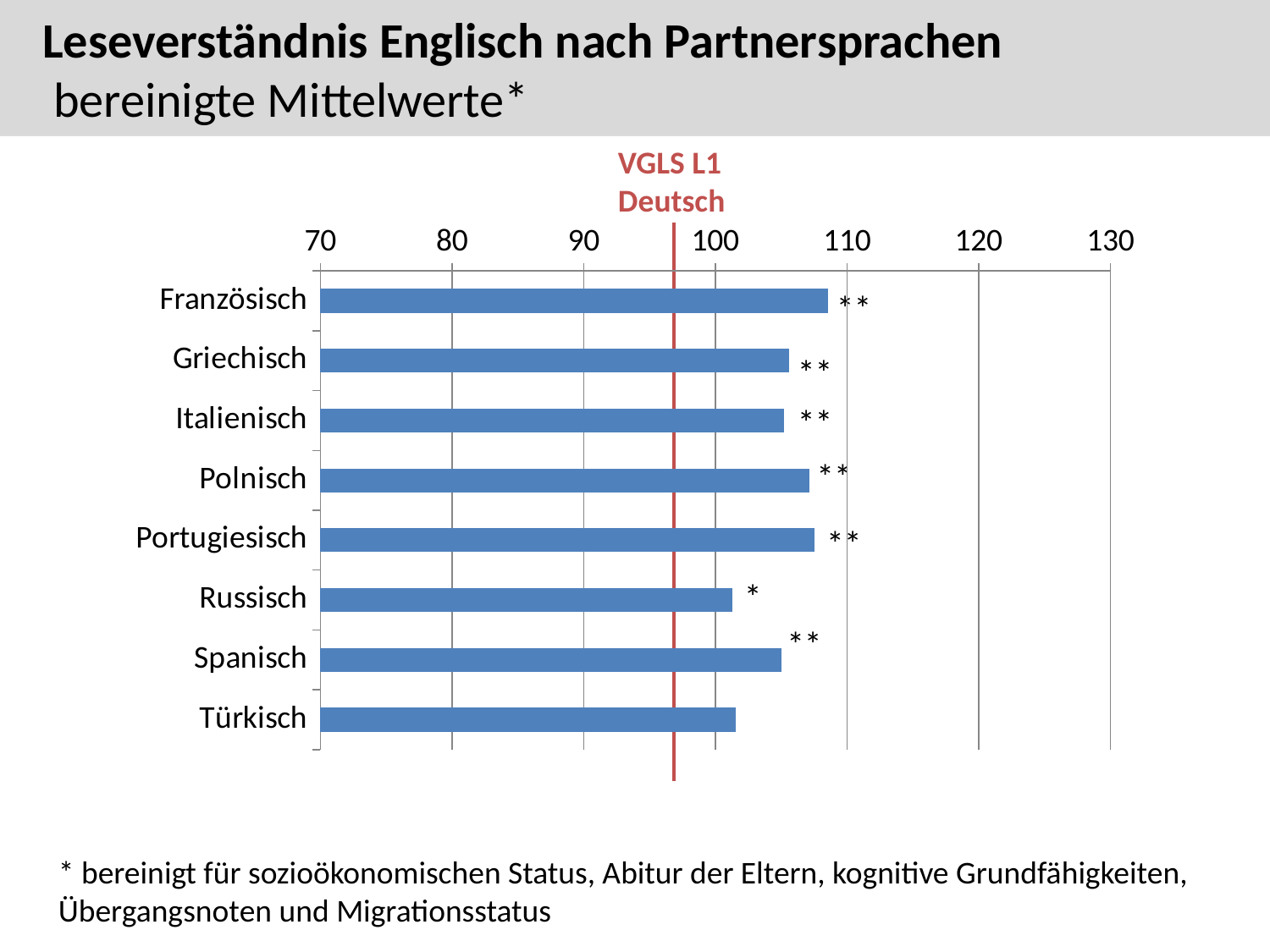
Is the value for Französisch greater or less than 100? greater Is the value for Griechisch greater or less than 100? greater How many partner languages (categories) are plotted in the chart? 8 Which has the larger value, Französisch or Russisch? Französisch Is the value for Polnisch greater or less than 110? less What kind of chart is shown on the slide? bar chart What label is given to the red vertical reference line in the chart? VGLS L1 Deutsch Which partner language has the highest value in the chart? Französisch What are the lowest and highest values shown on the chart's value axis? 70 and 130 Which has the larger value, Portugiesisch or Türkisch? Portugiesisch